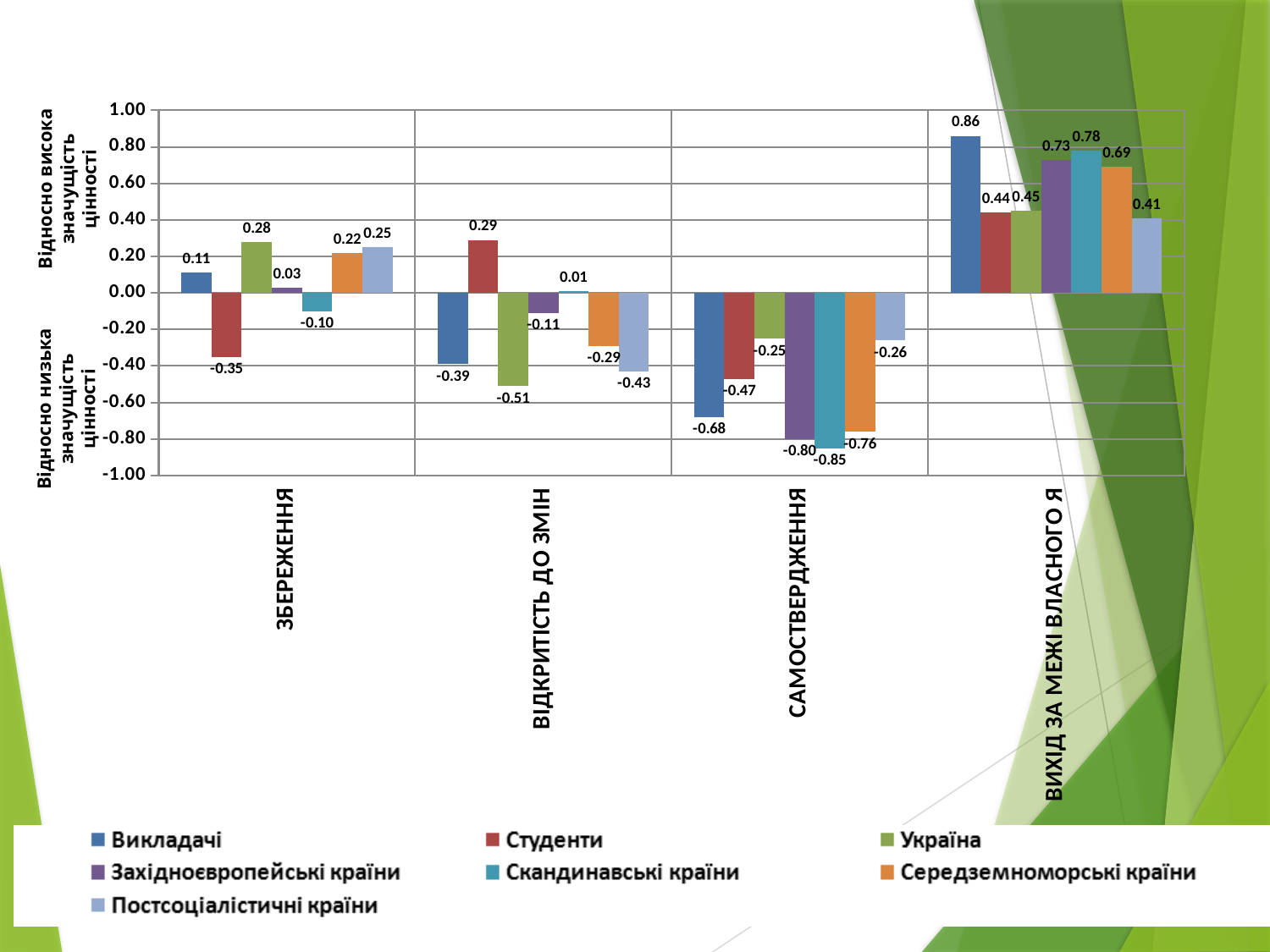
Which series has the lowest value in the САМОСТВЕРДЖЕННЯ category? Скандинавські країни How many categories are shown on the x axis? 4 What is the value for Скандинавські країни in the САМОСТВЕРДЖЕННЯ category? -0.85 How many series does the legend list? 7 In the ЗБЕРЕЖЕННЯ category, which is larger: the value for Україна or the value for Постсоціалістичні країни? Україна What is the value for Студенти in the ЗБЕРЕЖЕННЯ category? -0.35 What is the difference between the Викладачі and Студенти values in the ВИХІД ЗА МЕЖІ ВЛАСНОГО Я category? 0.42 Which series has the highest value in the ВИХІД ЗА МЕЖІ ВЛАСНОГО Я category? Викладачі Which series is shown in orange in the legend? Середземноморські країни What is the value for Україна in the ВІДКРИТІСТЬ ДО ЗМІН category? -0.51 What is the value for Викладачі in the ВИХІД ЗА МЕЖІ ВЛАСНОГО Я category? 0.86 What kind of chart is shown on the slide? Bar chart